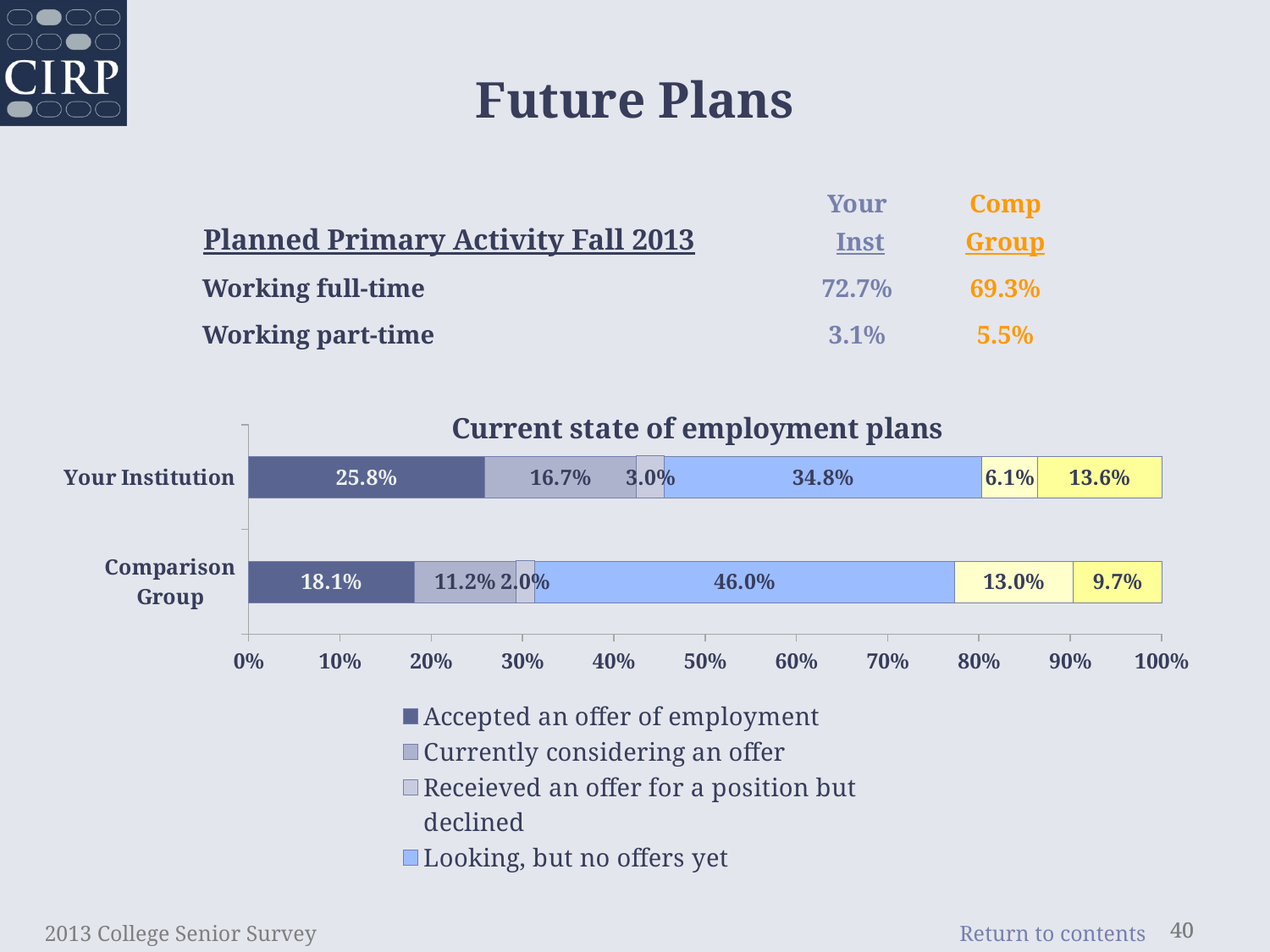
In the 'Current state of employment plans' chart, what percentage of the Comparison Group is looking, but has no offers yet? 46.0% In the 'Current state of employment plans' chart, what is the total of all segments in the Comparison Group bar? 100.0% How many groups (bars) are shown in the 'Current state of employment plans' chart? 2 In the 'Current state of employment plans' chart, which group has the larger share for 'Looking, but no offers yet'? Comparison Group What kind of chart is 'Current state of employment plans'? Stacked bar chart In the 'Current state of employment plans' chart, what is the difference between the Comparison Group and Your Institution for 'Looking, but no offers yet'? 11.2 percentage points In the 'Current state of employment plans' chart, what percentage of Your Institution has accepted an offer of employment? 25.8% What is the title of the chart on the slide? Current state of employment plans In the 'Current state of employment plans' chart, which segment is the largest in the Your Institution bar? Looking, but no offers yet (34.8%) In the 'Current state of employment plans' chart, what percentage of Your Institution received an offer for a position but declined? 3.0% In the 'Current state of employment plans' chart, what percentage of the Comparison Group is currently considering an offer? 11.2% In the 'Current state of employment plans' chart, how much higher is the 'Accepted an offer of employment' share for Your Institution than for the Comparison Group? 7.7 percentage points